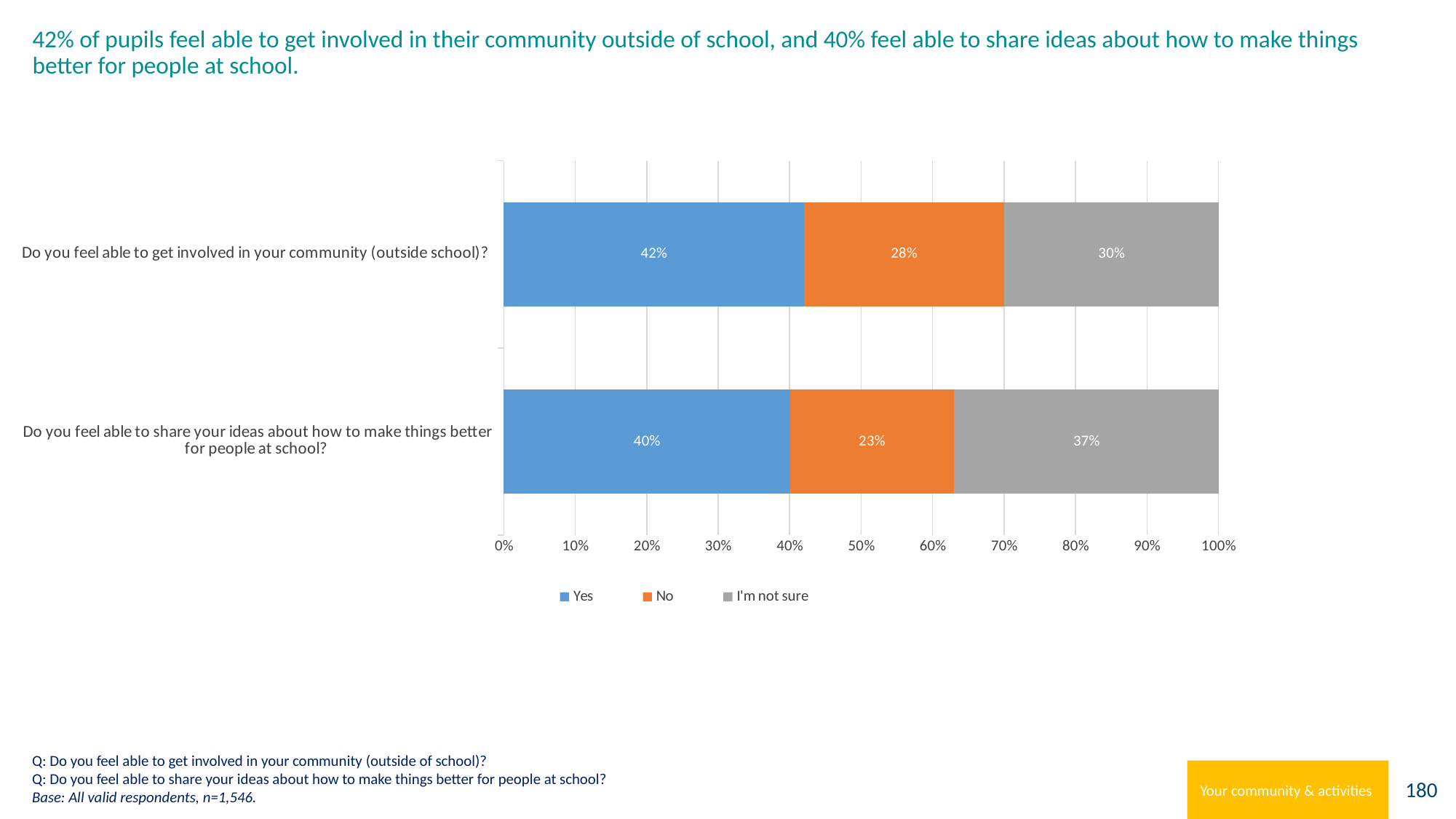
What is the difference between the 'No' percentages for the two questions? 5% Which question has the larger 'I'm not sure' share? Do you feel able to share your ideas about how to make things better for people at school? How many questions (bars) are shown in the chart? 2 What percentage of pupils answered 'I'm not sure' to 'Do you feel able to share your ideas about how to make things better for people at school?' 37% How many series does the legend list? 3 Which response was least common for 'Do you feel able to get involved in your community (outside school)?' No What percentage of pupils answered 'I'm not sure' to 'Do you feel able to get involved in your community (outside school)?' 30% What kind of chart is shown on the slide? Stacked bar chart What percentage of pupils answered 'Yes' to 'Do you feel able to get involved in your community (outside school)?' 42% Which response was most common for 'Do you feel able to share your ideas about how to make things better for people at school?' Yes What percentage of pupils answered 'No' to 'Do you feel able to share your ideas about how to make things better for people at school?' 23% What colour represents the 'No' response in the chart? Orange